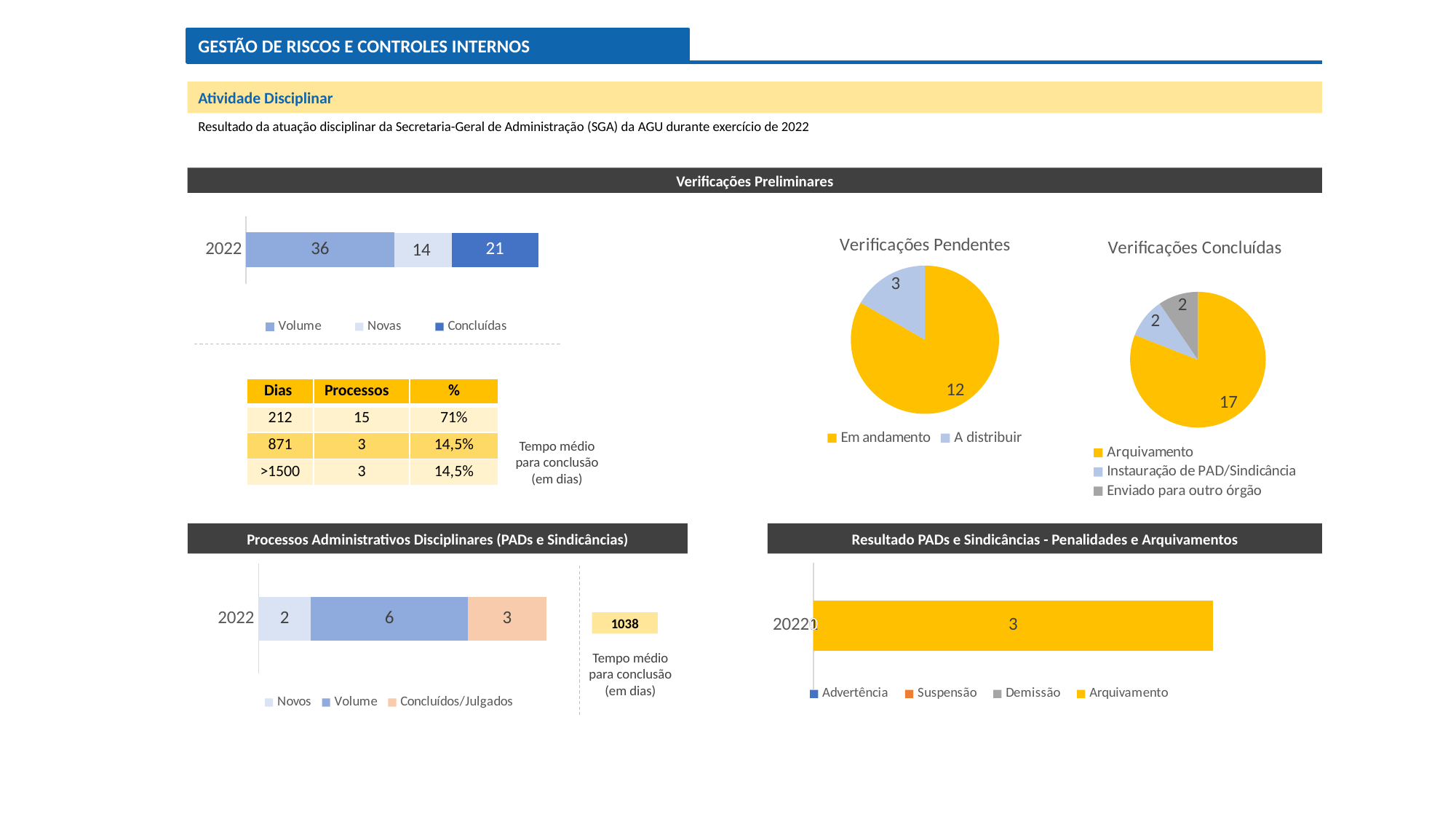
In the stacked bar chart under 'Verificações Preliminares', what is the value for Volume in 2022? 36 How many slices does the 'Verificações Concluídas' pie chart have? 3 In the 'Verificações Concluídas' pie chart, which category is the largest? Arquivamento In the stacked bar chart under 'Verificações Preliminares', which series has the lowest value? Novas In the stacked bar chart under 'Processos Administrativos Disciplinares (PADs e Sindicâncias)', what is the value for Volume? 6 In the stacked bar chart under 'Verificações Preliminares', what is the value for Concluídas in 2022? 21 In the 'Verificações Concluídas' pie chart, what is the value for Arquivamento? 17 In the stacked bar chart under 'Processos Administrativos Disciplinares (PADs e Sindicâncias)', what is the total of the 2022 bar? 11 How many series does the legend of the chart under 'Resultado PADs e Sindicâncias - Penalidades e Arquivamentos' list? 4 In the 'Verificações Pendentes' pie chart, what is the value for Em andamento? 12 In the stacked bar chart under 'Verificações Preliminares', what is the difference between Volume and Concluídas? 15